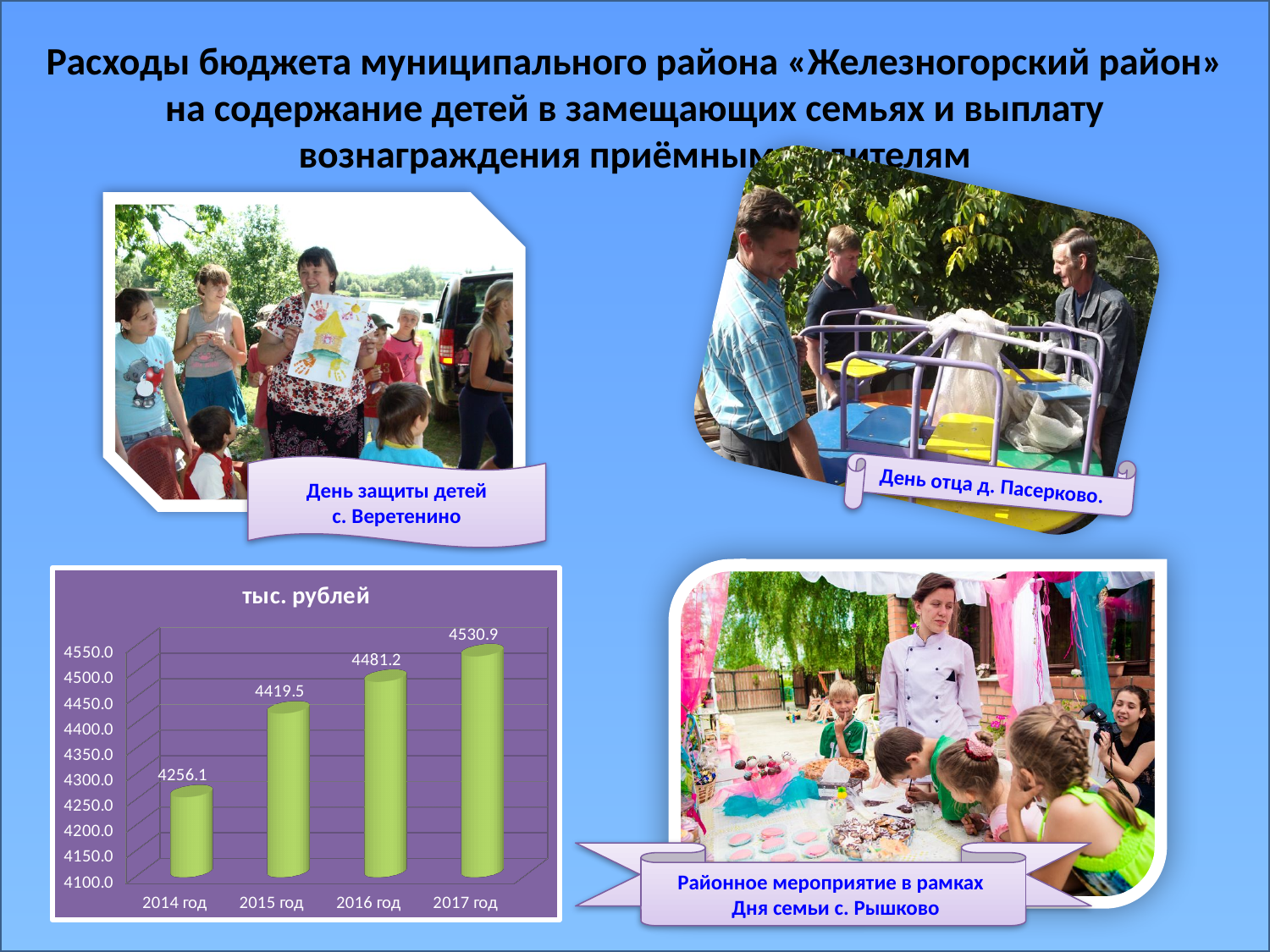
What is the difference between the values for 2017 год and 2014 год? 274.8 Which is larger, the value for 2016 год or the value for 2015 год? 2016 год What is the difference between the values for 2015 год and 2014 год? 163.4 What is the value for 2015 год? 4419.5 Do the values rise or fall from 2014 год to 2017 год? rise How many years are shown on the chart? 4 What kind of chart is shown on the slide? bar chart What is the value for 2017 год? 4530.9 What is the value for 2014 год? 4256.1 What is the value for 2016 год? 4481.2 Which year has the highest value? 2017 год Which year has the lowest value? 2014 год